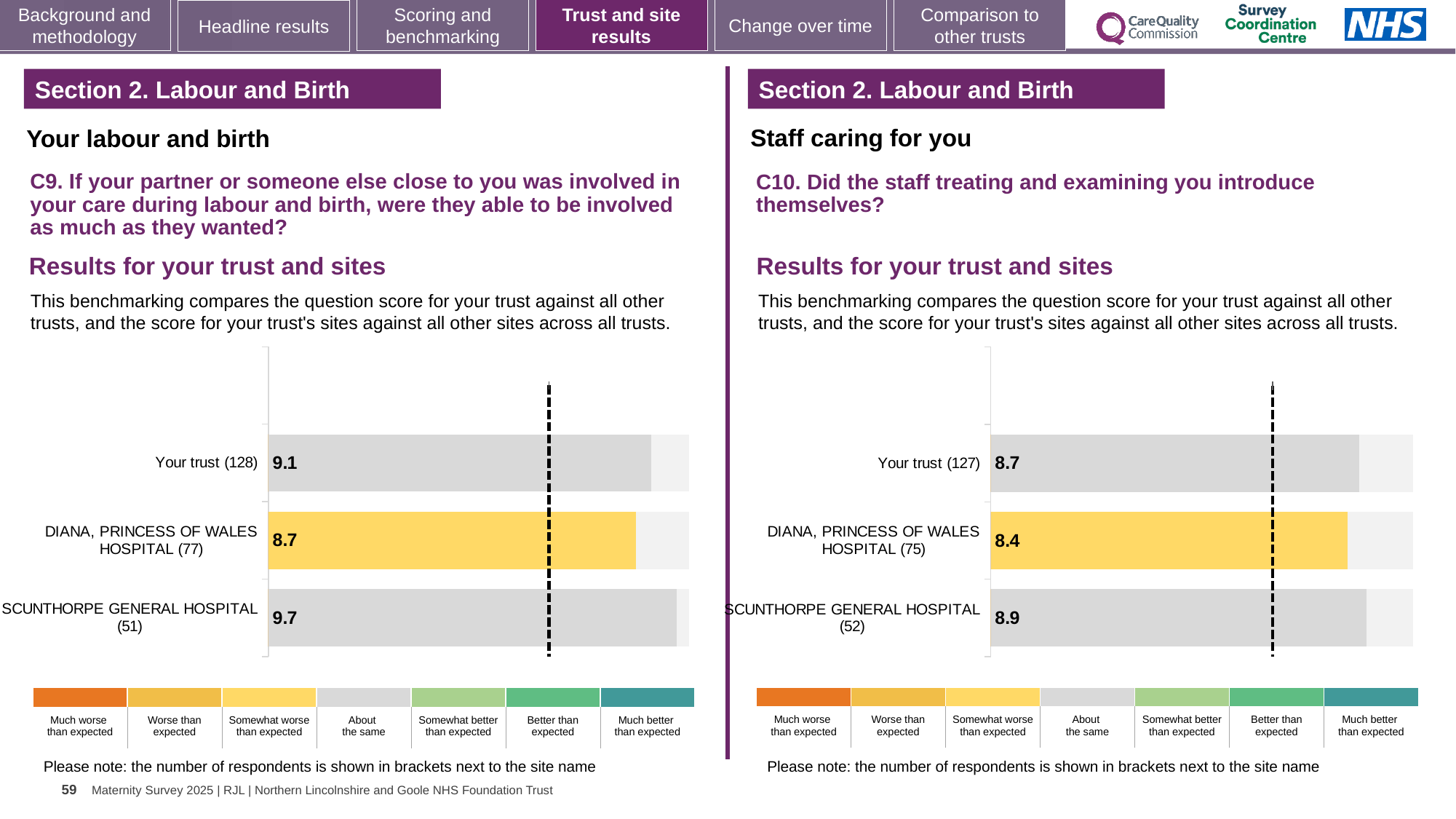
Which is larger: the score for Your trust in the left chart (C9) or the score for Your trust in the right chart (C10)? Left chart (C9), 9.1 How many bars are shown in the left chart (C9)? 3 In the left chart (C9), what is the score for Your trust? 9.1 In the left chart (C9), which site or trust has the highest score? SCUNTHORPE GENERAL HOSPITAL In the right chart (C10), which site or trust has the lowest score? DIANA, PRINCESS OF WALES HOSPITAL In the right chart (C10), what is the score for Your trust? 8.7 In the right chart (C10), what is the score for SCUNTHORPE GENERAL HOSPITAL? 8.9 In the right chart (C10), what is the difference between the scores for Your trust and DIANA, PRINCESS OF WALES HOSPITAL? 0.3 In the left chart (C9), what is the score for DIANA, PRINCESS OF WALES HOSPITAL? 8.7 In the left chart (C9), what is the difference between the scores for SCUNTHORPE GENERAL HOSPITAL and Your trust? 0.6 What type of chart is used in the right chart (C10)? Bar chart In the left chart (C9), which site or trust has the lowest score? DIANA, PRINCESS OF WALES HOSPITAL